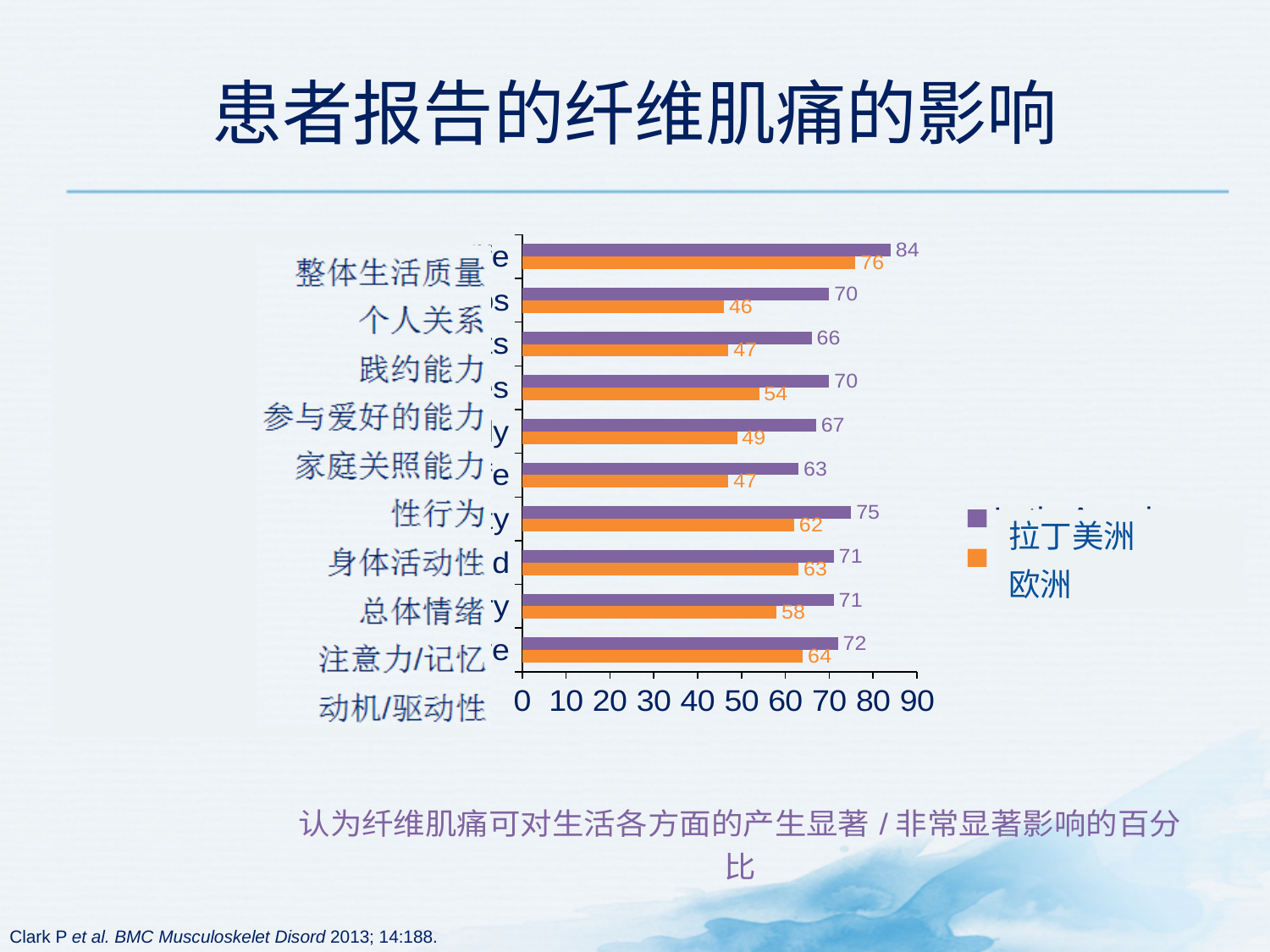
What is the value for 欧洲 for 整体生活质量? 76 How many series does the legend list? 2 What kind of chart is shown on the slide? bar chart Which category has the lowest value for 欧洲? 个人关系 Which category has the highest value for 拉丁美洲? 整体生活质量 What is the value for 欧洲 for 个人关系? 46 What is the value for 拉丁美洲 for 动机/驱动性? 72 Which colour represents 欧洲 in the chart? orange What is the difference between the 拉丁美洲 and 欧洲 values for 个人关系? 24 How many categories are plotted in the chart? 10 Which is larger for 身体活动性: the 拉丁美洲 value or the 欧洲 value? 拉丁美洲 What is the value for 拉丁美洲 for 整体生活质量? 84